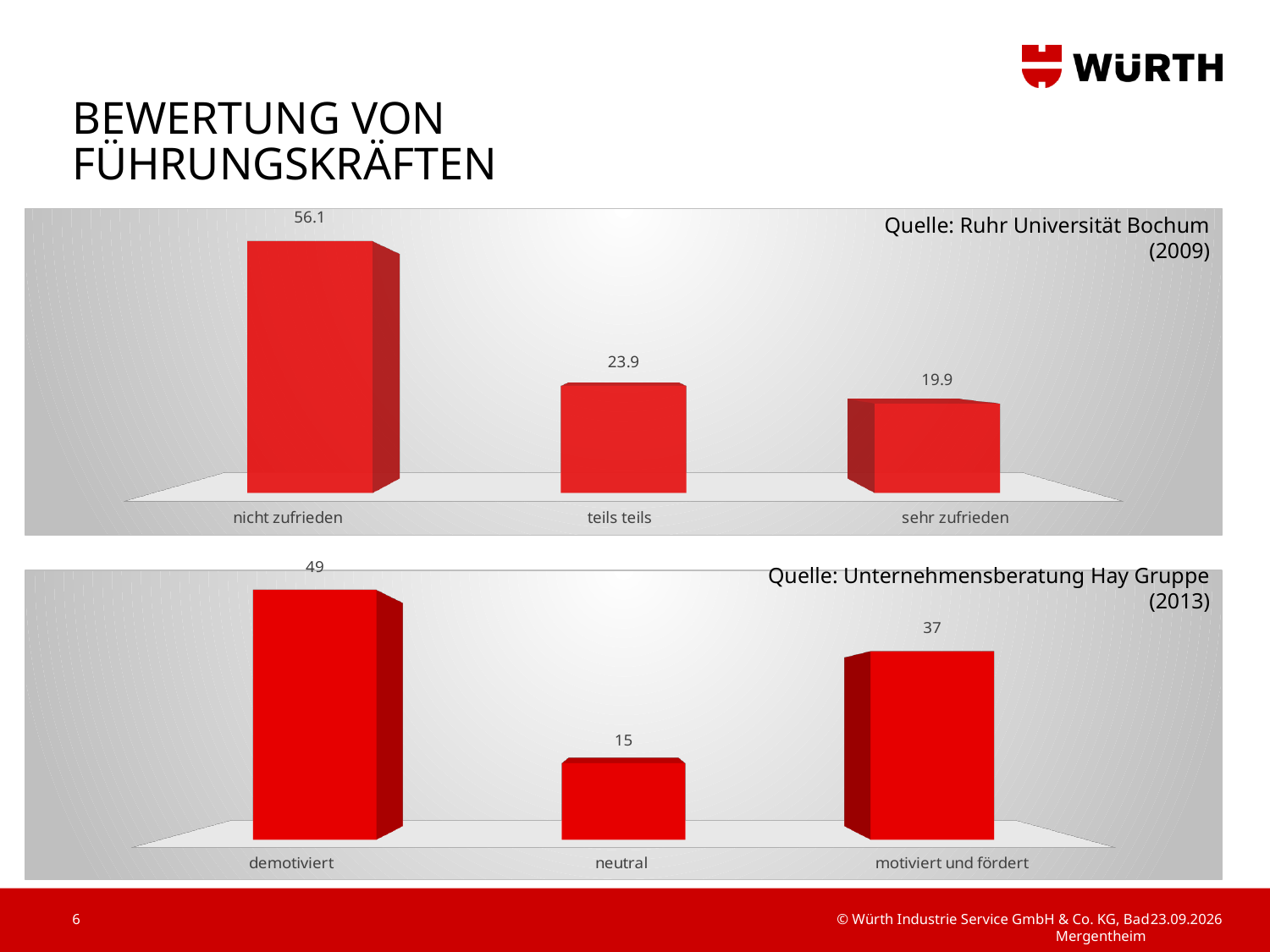
In the bottom chart (Quelle: Unternehmensberatung Hay Gruppe), which category has the highest value? demotiviert In the bottom chart (Quelle: Unternehmensberatung Hay Gruppe), what is the value for "neutral"? 15 In the top chart (Quelle: Ruhr Universität Bochum), which category has the highest value? nicht zufrieden In the top chart (Quelle: Ruhr Universität Bochum), what is the value for "nicht zufrieden"? 56.1 In the top chart (Quelle: Ruhr Universität Bochum), what is the difference between "nicht zufrieden" and "teils teils"? 32.2 In the bottom chart (Quelle: Unternehmensberatung Hay Gruppe), what is the value for "motiviert und fördert"? 37 In the top chart (Quelle: Ruhr Universität Bochum), which category has the lowest value? sehr zufrieden In the bottom chart (Quelle: Unternehmensberatung Hay Gruppe), what is the difference between "demotiviert" and "motiviert und fördert"? 12 In the bottom chart (Quelle: Unternehmensberatung Hay Gruppe), which is larger, "neutral" or "motiviert und fördert"? motiviert und fördert What type of chart is the bottom chart (Quelle: Unternehmensberatung Hay Gruppe)? bar chart In the top chart (Quelle: Ruhr Universität Bochum), how many categories are shown? 3 In the top chart (Quelle: Ruhr Universität Bochum), what is the value for "sehr zufrieden"? 19.9